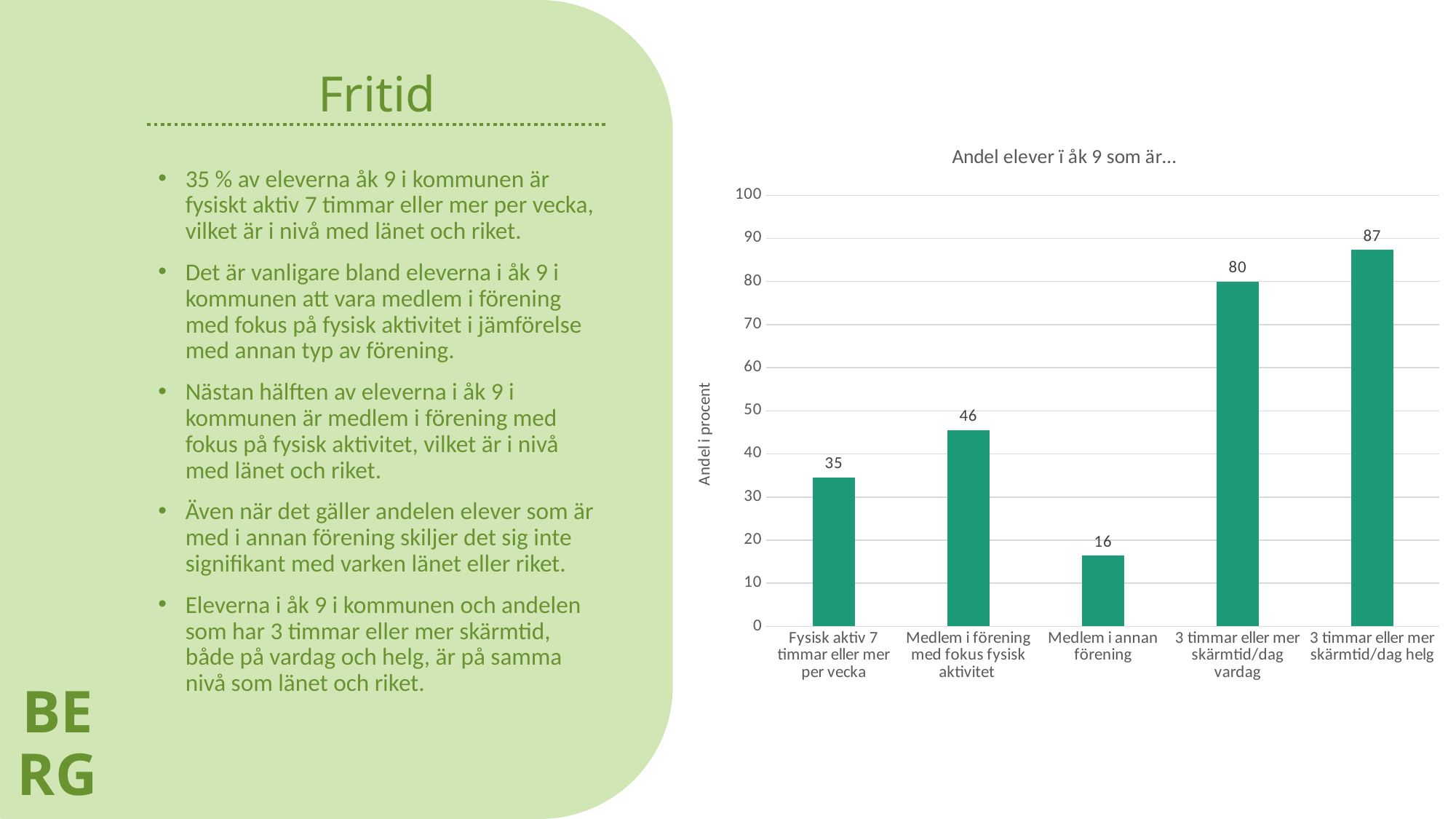
What is the title of the chart? Andel elever ï åk 9 som är… What kind of chart is shown on the slide? bar chart Which is larger: "Medlem i förening med fokus fysisk aktivitet" or "Medlem i annan förening"? Medlem i förening med fokus fysisk aktivitet What is the value for "Fysisk aktiv 7 timmar eller mer per vecka"? 35 Which category has the highest value? 3 timmar eller mer skärmtid/dag helg How many categories are shown in the chart? 5 What is the value for "Medlem i annan förening"? 16 What is the value for "Medlem i förening med fokus fysisk aktivitet"? 46 What is the value for "3 timmar eller mer skärmtid/dag helg"? 87 What is the difference between "3 timmar eller mer skärmtid/dag helg" and "3 timmar eller mer skärmtid/dag vardag"? 7 Is the value for "3 timmar eller mer skärmtid/dag vardag" greater or less than 70? greater Which category has the lowest value? Medlem i annan förening